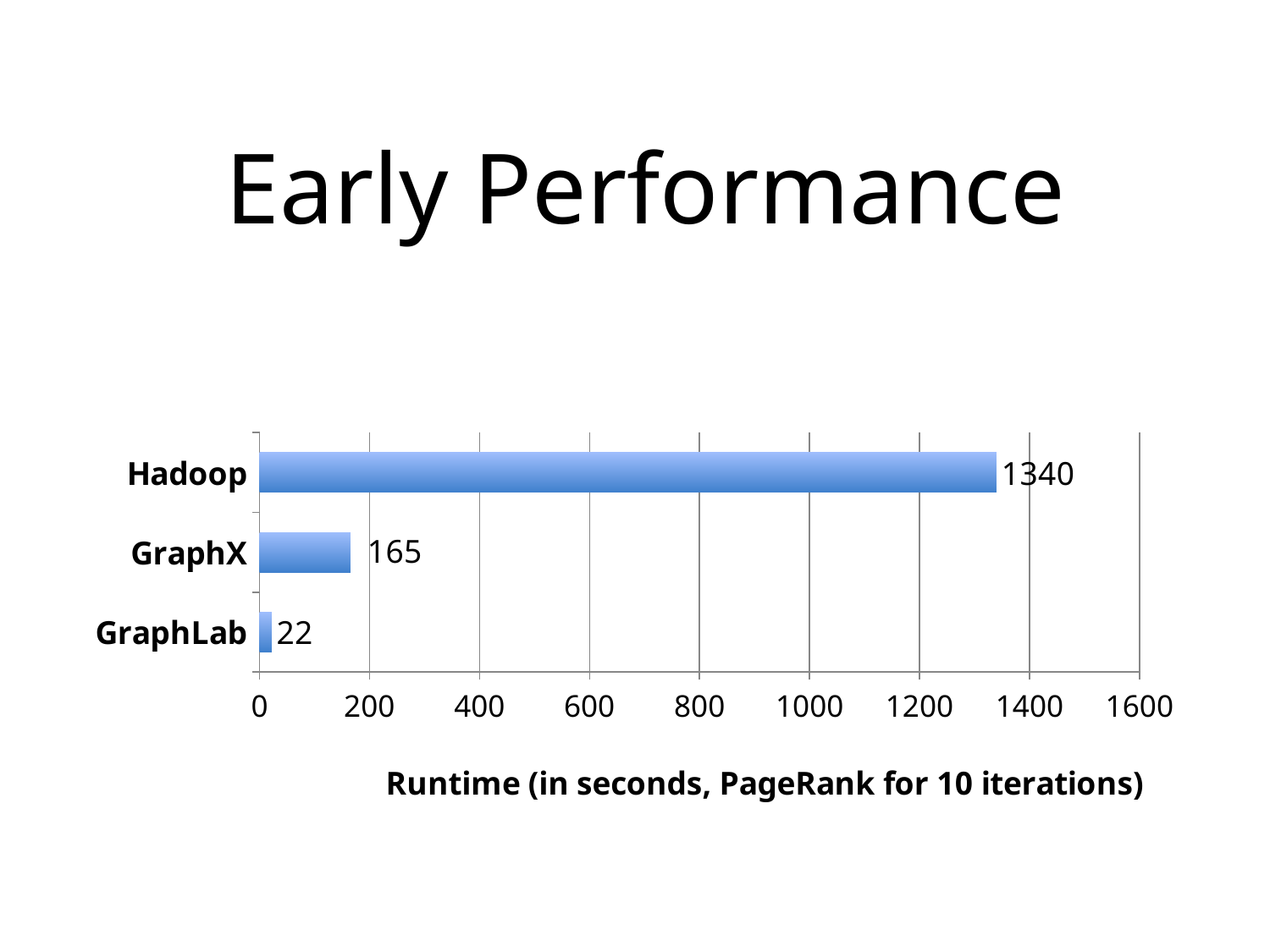
What is the label of the horizontal axis of the chart? Runtime (in seconds, PageRank for 10 iterations) Which has a larger runtime, GraphX or GraphLab? GraphX What is the runtime value shown for Hadoop? 1340 What is the runtime value shown for GraphLab? 22 What is the difference in runtime between GraphX and GraphLab? 143 Is the runtime for Hadoop greater or less than 1200? greater How many systems are compared in the chart? 3 Which system has the highest runtime? Hadoop Which system has the lowest runtime? GraphLab What is the difference in runtime between Hadoop and GraphX? 1175 What kind of chart is shown on the slide? Bar chart What is the runtime value shown for GraphX? 165